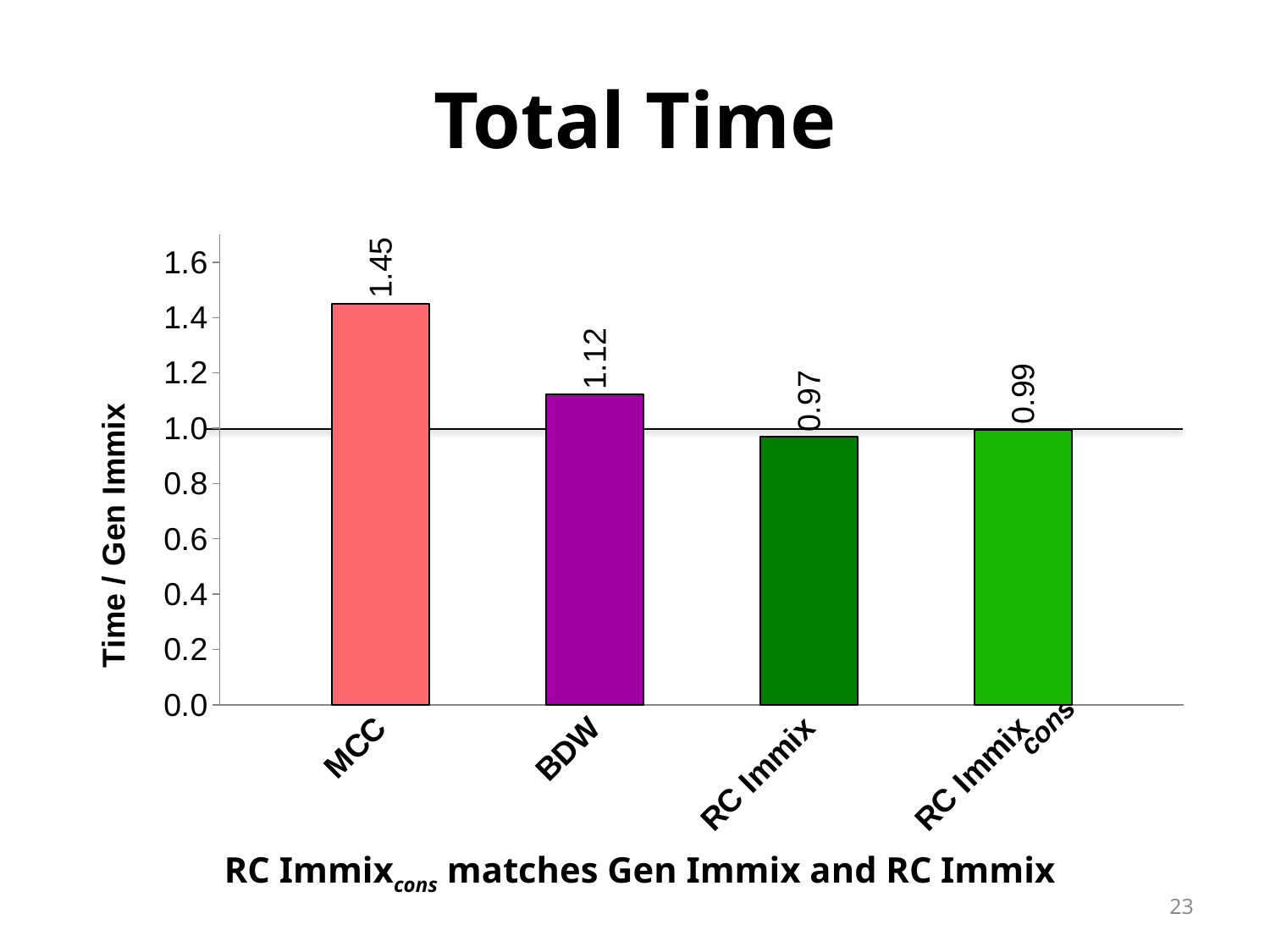
What is the value for MCC? 1.45 Is the value for MCC greater or less than 1.4? greater What kind of chart is shown on the slide? bar chart Which is larger, the value for BDW or the value for RC Immix cons? BDW Which category has the highest value? MCC How many categories are shown on the x axis? 4 What is the title of the chart? Total Time What is the value for RC Immix? 0.97 What is the value for BDW? 1.12 What is the value for RC Immix cons? 0.99 What is the difference between the values for MCC and BDW? 0.33 Which category has the lowest value? RC Immix